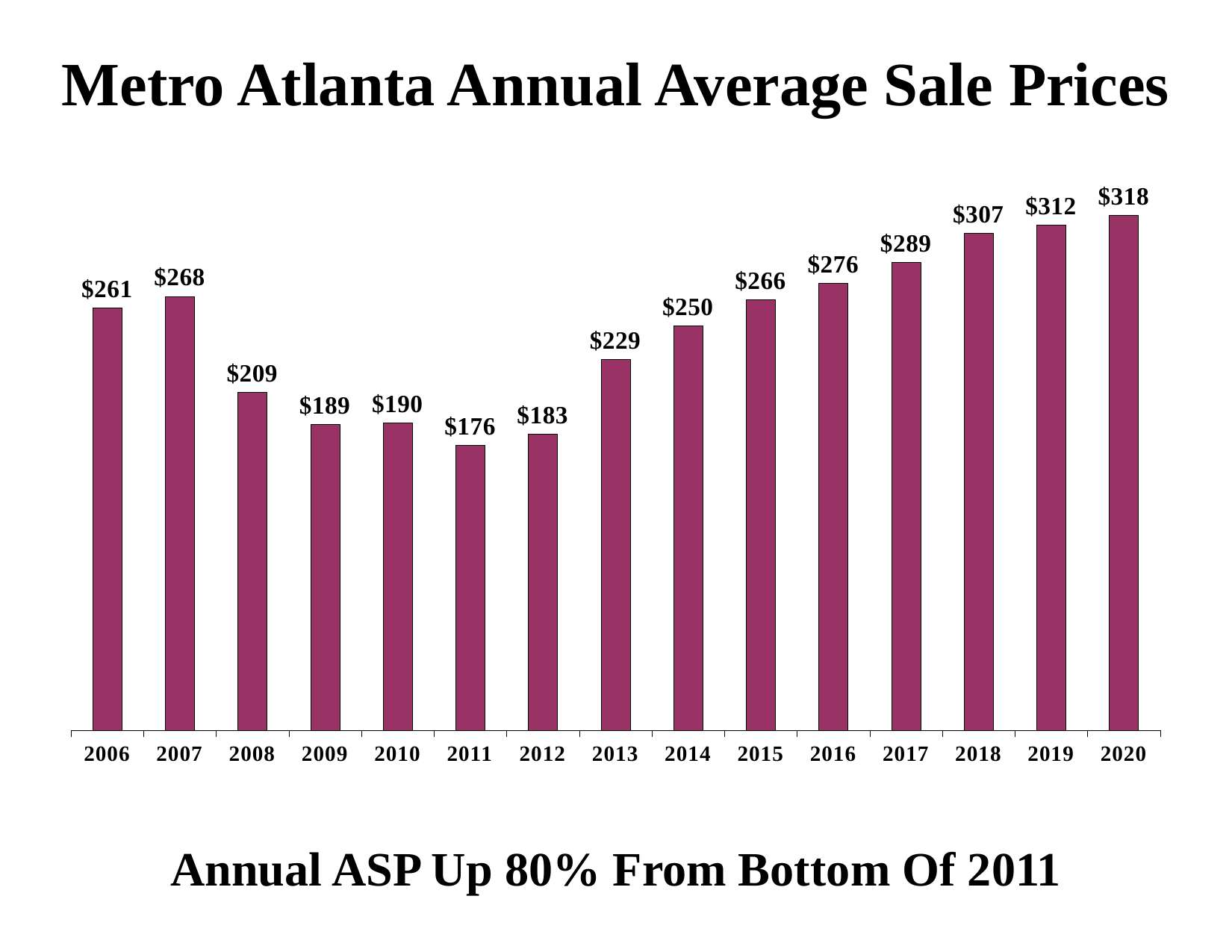
Do the values rise or fall from 2011 to 2020? Rise Which year has the lowest average sale price? 2011 What kind of chart is shown on the slide? Bar chart What is the average sale price shown for 2011? $176 What is the average sale price shown for 2016? $276 How many years are shown on the x axis? 15 What is the difference between the 2007 value and the 2008 value? $59 Which is larger, the value for 2009 or the value for 2012? 2009 What is the difference between the 2020 value and the 2011 value? $142 Which year has the highest average sale price? 2020 What is the title of the chart? Metro Atlanta Annual Average Sale Prices Which is larger, the value for 2006 or the value for 2015? 2015